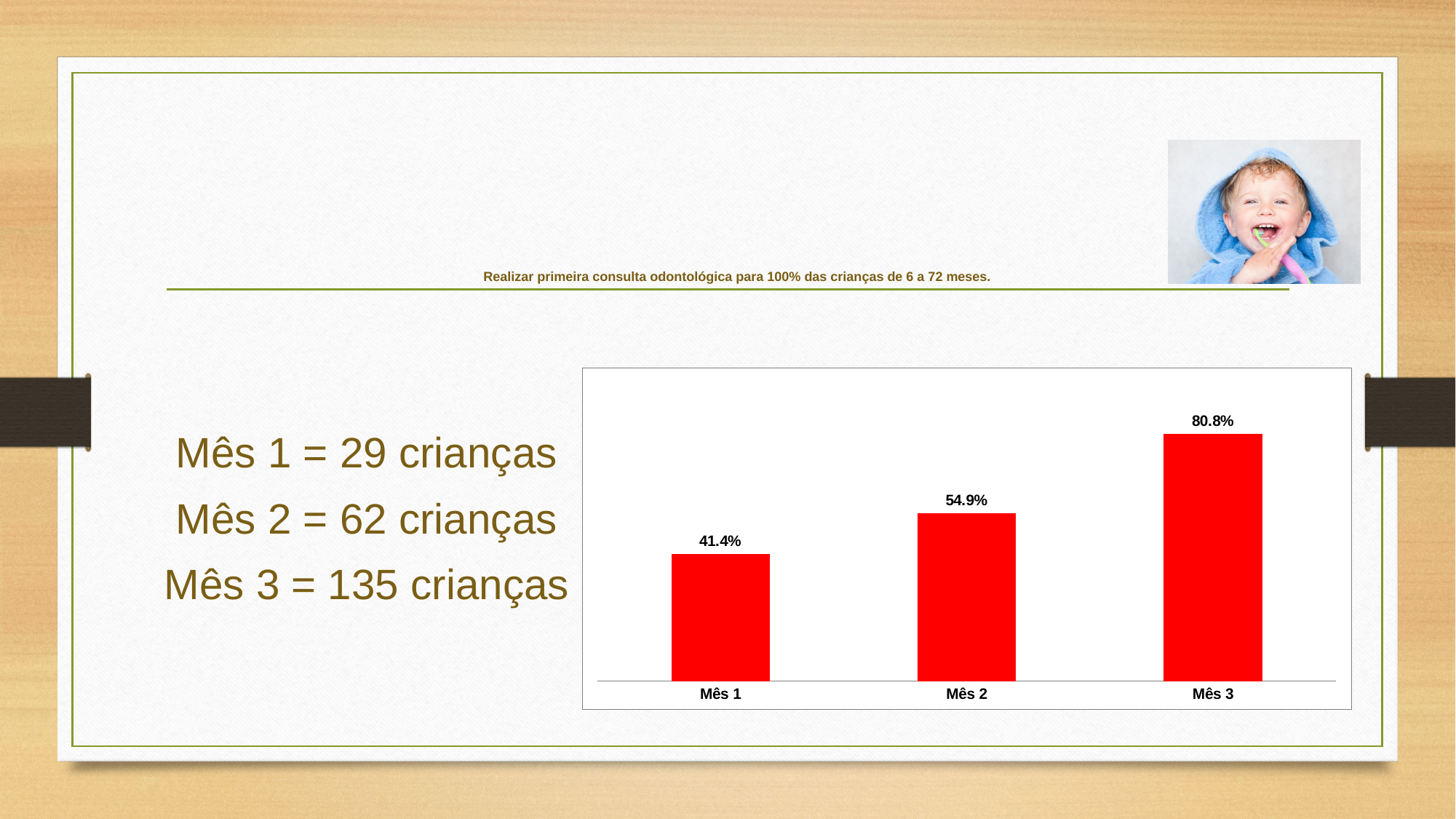
Which month has the lowest value? Mês 1 Which is larger, the value for Mês 2 or the value for Mês 3? Mês 3 What is the difference between the values for Mês 3 and Mês 1? 39.4% What colour are the bars in the chart? Red Which month has the highest value? Mês 3 What is the value for Mês 1? 41.4% What is the value for Mês 2? 54.9% What is the difference between the values for Mês 2 and Mês 1? 13.5% What is the value for Mês 3? 80.8% Do the values rise or fall from Mês 1 to Mês 3? Rise What kind of chart is shown on the slide? Bar chart How many bars are shown in the chart? 3